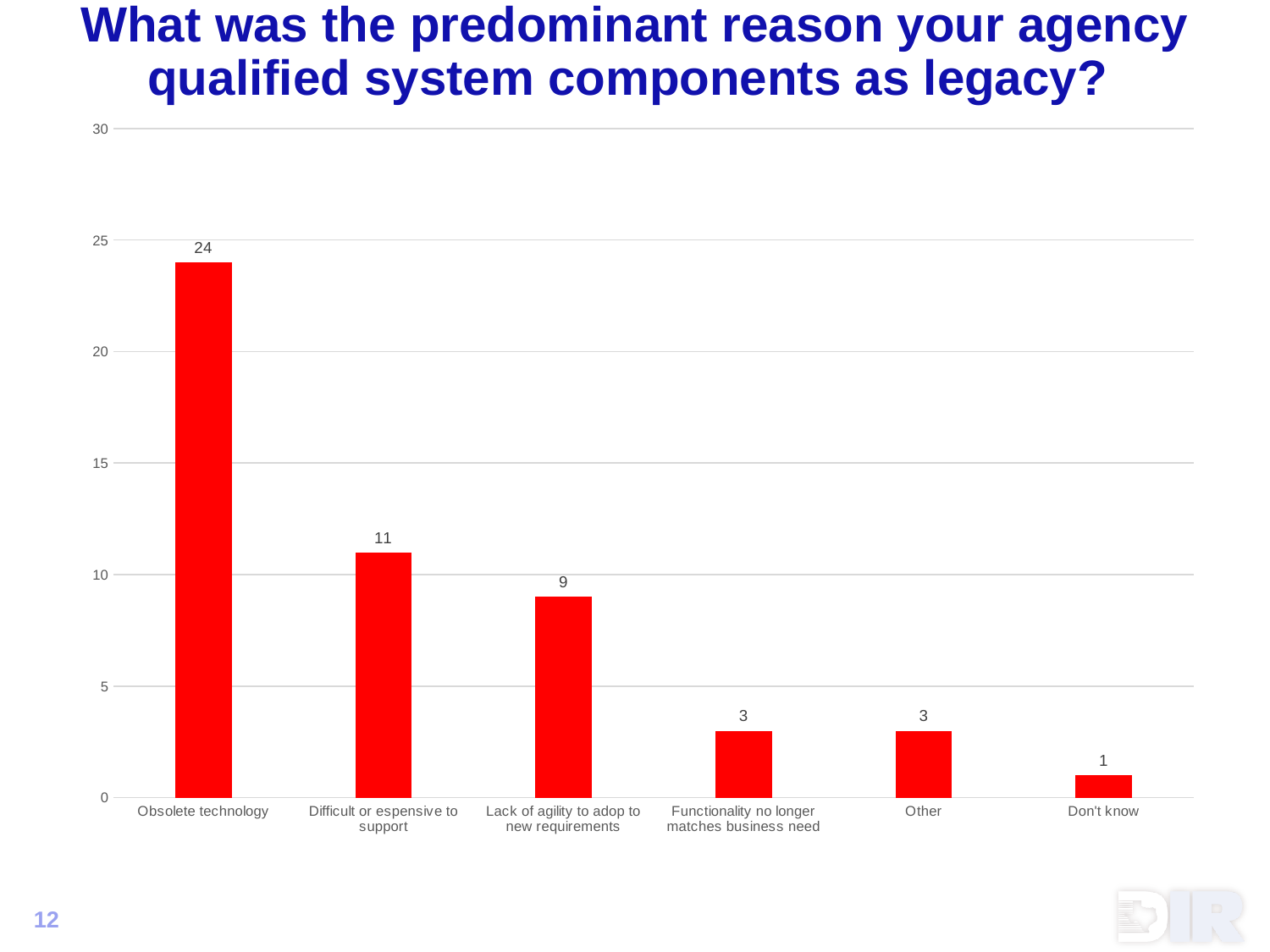
Which category has the highest value? Obsolete technology What is the value for Lack of agility to adop to new requirements? 9 What kind of chart is shown on the slide? bar chart What colour are the bars in the chart? red Which category has the lowest value? Don't know What is the value for Obsolete technology? 24 What is the value for Difficult or espensive to support? 11 Which is larger, the value for Lack of agility to adop to new requirements or the value for Other? Lack of agility to adop to new requirements Is the value for Obsolete technology greater or less than 20? greater What is the value for Don't know? 1 What is the difference between the values for Obsolete technology and Difficult or espensive to support? 13 How many categories are shown on the x axis? 6